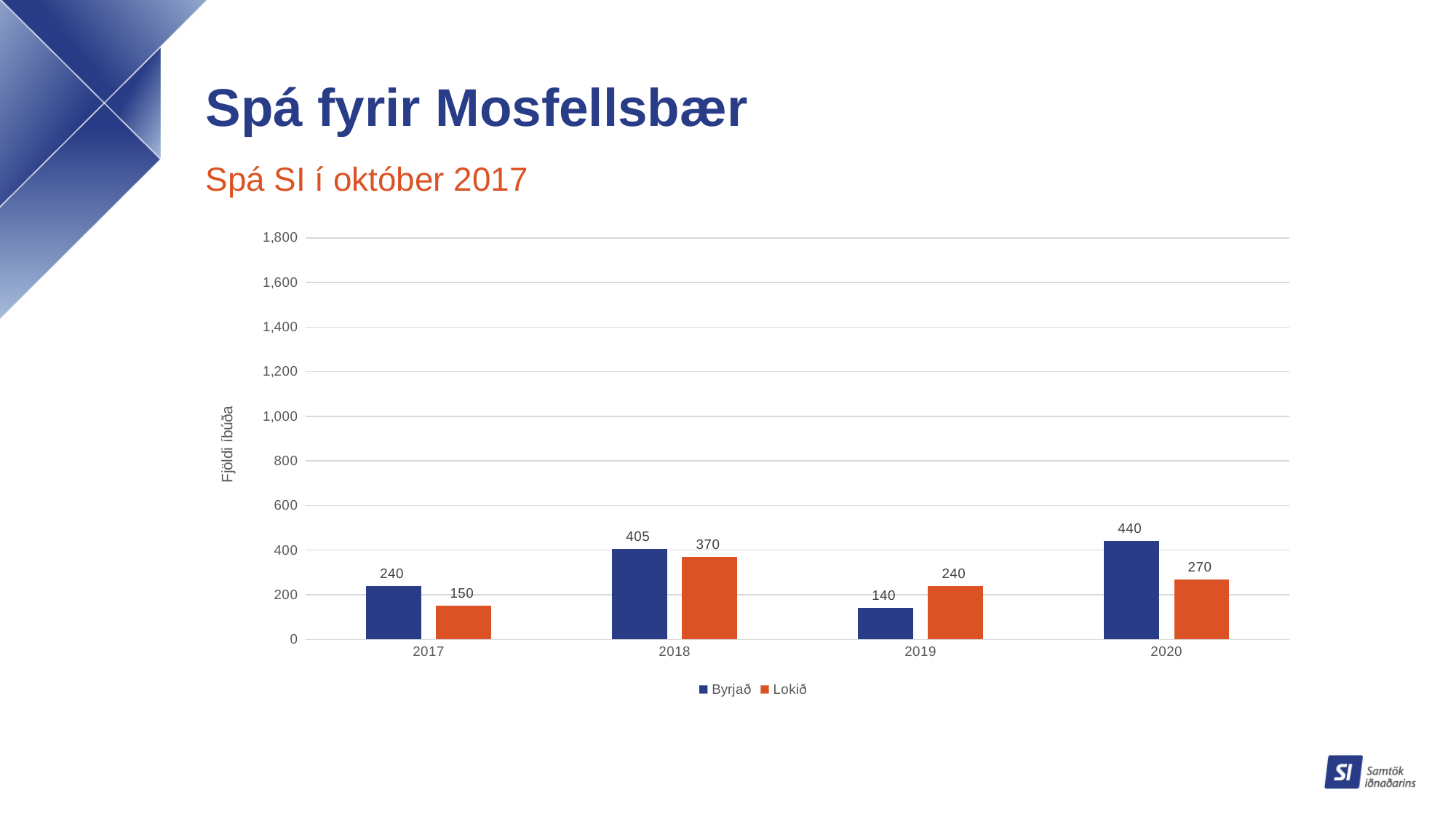
What is the value for Byrjað in 2018? 405 Which is larger in 2018, Byrjað or Lokið? Byrjað How many years are shown on the x axis? 4 How many series does the legend list? 2 What is the value for Lokið in 2017? 150 What is the label of the y axis? Fjöldi íbúða Which year has the highest value for Byrjað? 2020 What is the value for Lokið in 2020? 270 Which year has the lowest value for Lokið? 2017 What kind of chart is shown on the slide? bar chart What is the difference between Byrjað and Lokið in 2019? 100 Is the value for Byrjað in 2020 greater or less than 400? greater